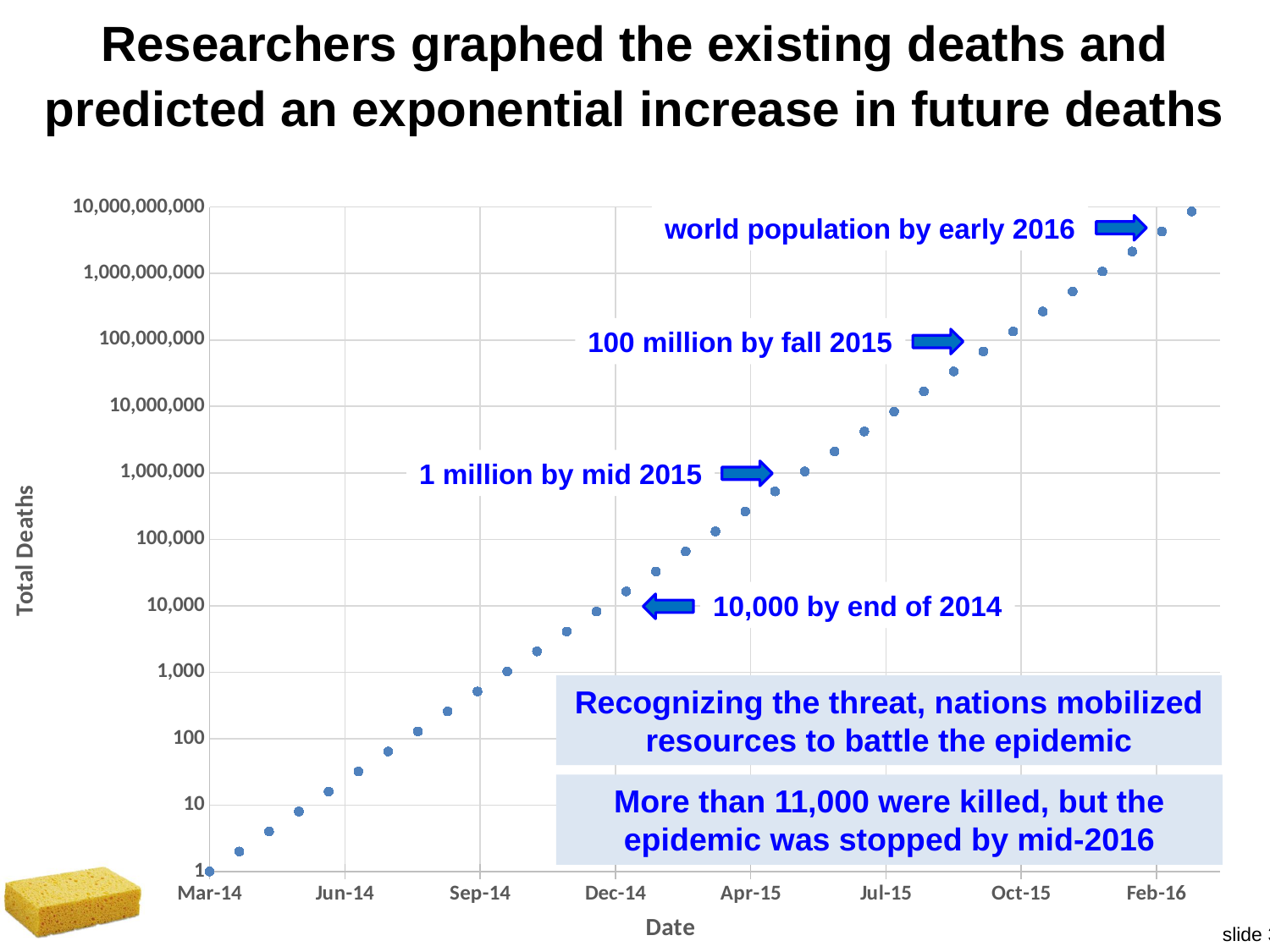
What kind of chart is shown on the slide? scatter chart What is the label of the vertical axis? Total Deaths Is the value plotted at Sep-14 greater or less than 1,000? less What is the highest tick value shown on the vertical axis? 10,000,000,000 Is the value plotted at Dec-14 greater or less than 1,000? greater What is the label of the horizontal axis? Date Is the value plotted at Jun-14 greater or less than 100? less Which has the larger plotted value, Dec-14 or Jun-14? Dec-14 Do the plotted values rise or fall as the date moves from Mar-14 to Feb-16? rise At which date on the x axis is the lowest plotted value? Mar-14